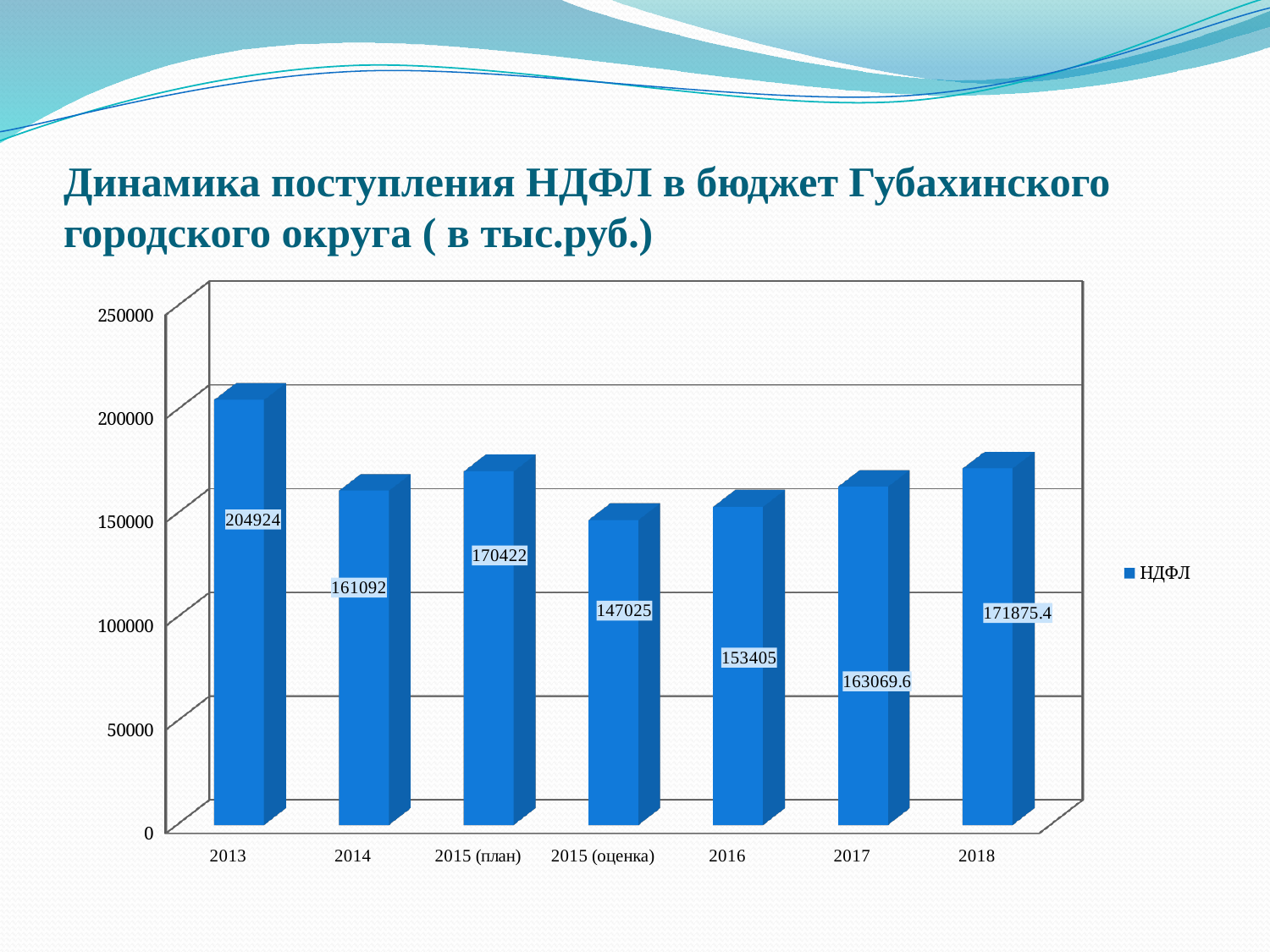
What series name does the legend show? НДФЛ What is the value for 2015 (оценка)? 147025 Which category has the highest value? 2013 Which category has the lowest value? 2015 (оценка) What kind of chart is this? bar chart What is the difference between the values for 2013 and 2014? 43832 How many categories are shown on the x axis? 7 Which is larger, the value for 2016 or the value for 2017? 2017 What is the difference between the values for 2015 (план) and 2015 (оценка)? 23397 What is the value for 2017? 163069.6 What is the value for 2013? 204924 What is the value for 2018? 171875.4